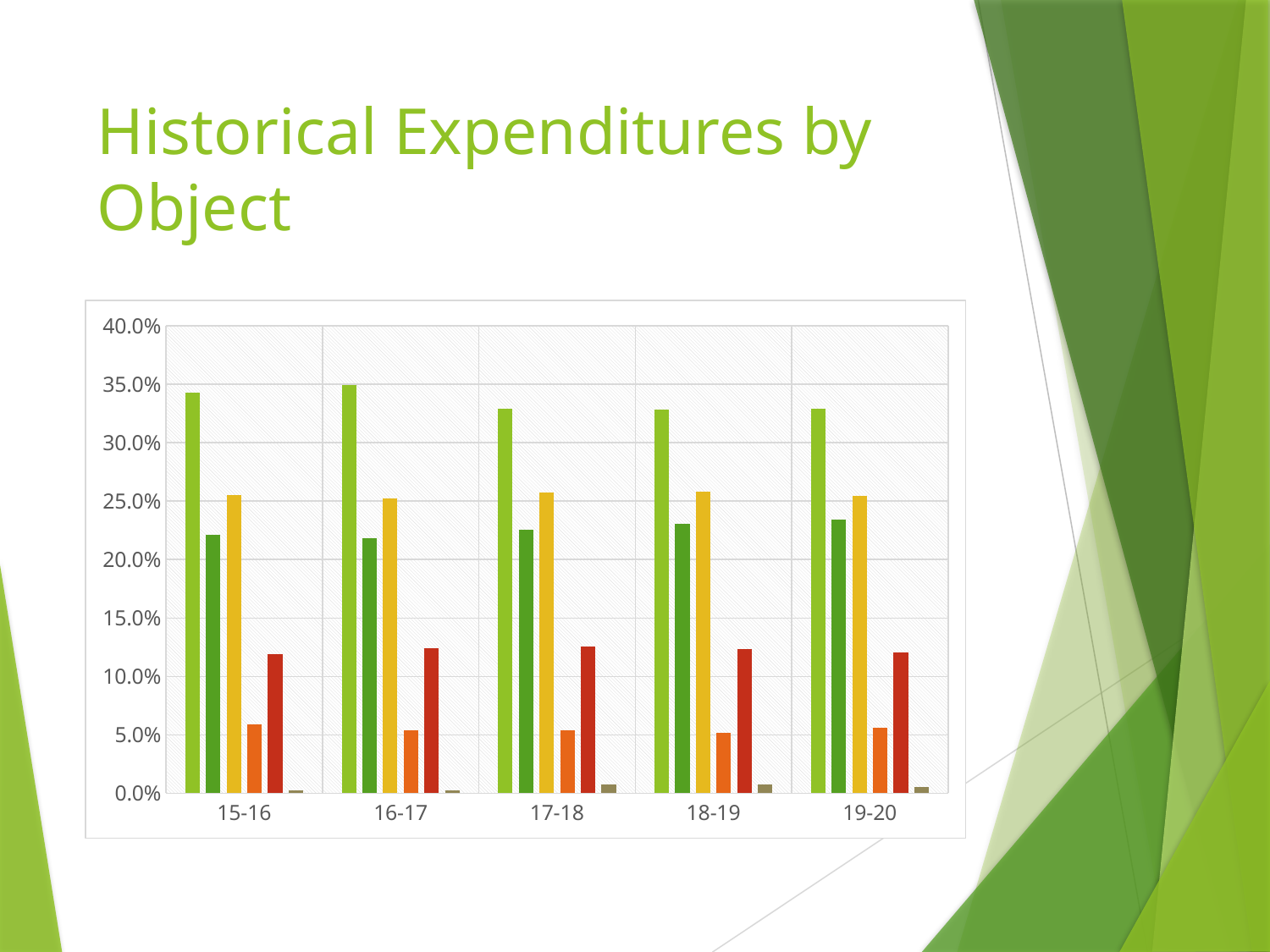
Is the value of the yellow bar for 19-20 greater or less than 20.0%? greater In the 15-16 group, which bar is larger, the light green bar or the yellow bar? the light green bar Is the value of the dark green bar for 18-19 greater or less than 20.0%? greater How many bars are plotted for each year category in the chart? 6 Is the value of the orange bar for 15-16 greater or less than 10.0%? less In the 19-20 group, which bar is larger, the red bar or the orange bar? the red bar What is the highest value shown on the chart's vertical axis? 40.0% How many year categories are shown on the x axis of the chart? 5 What is the title of the slide containing the chart? Historical Expenditures by Object What kind of chart is shown on the slide? bar chart